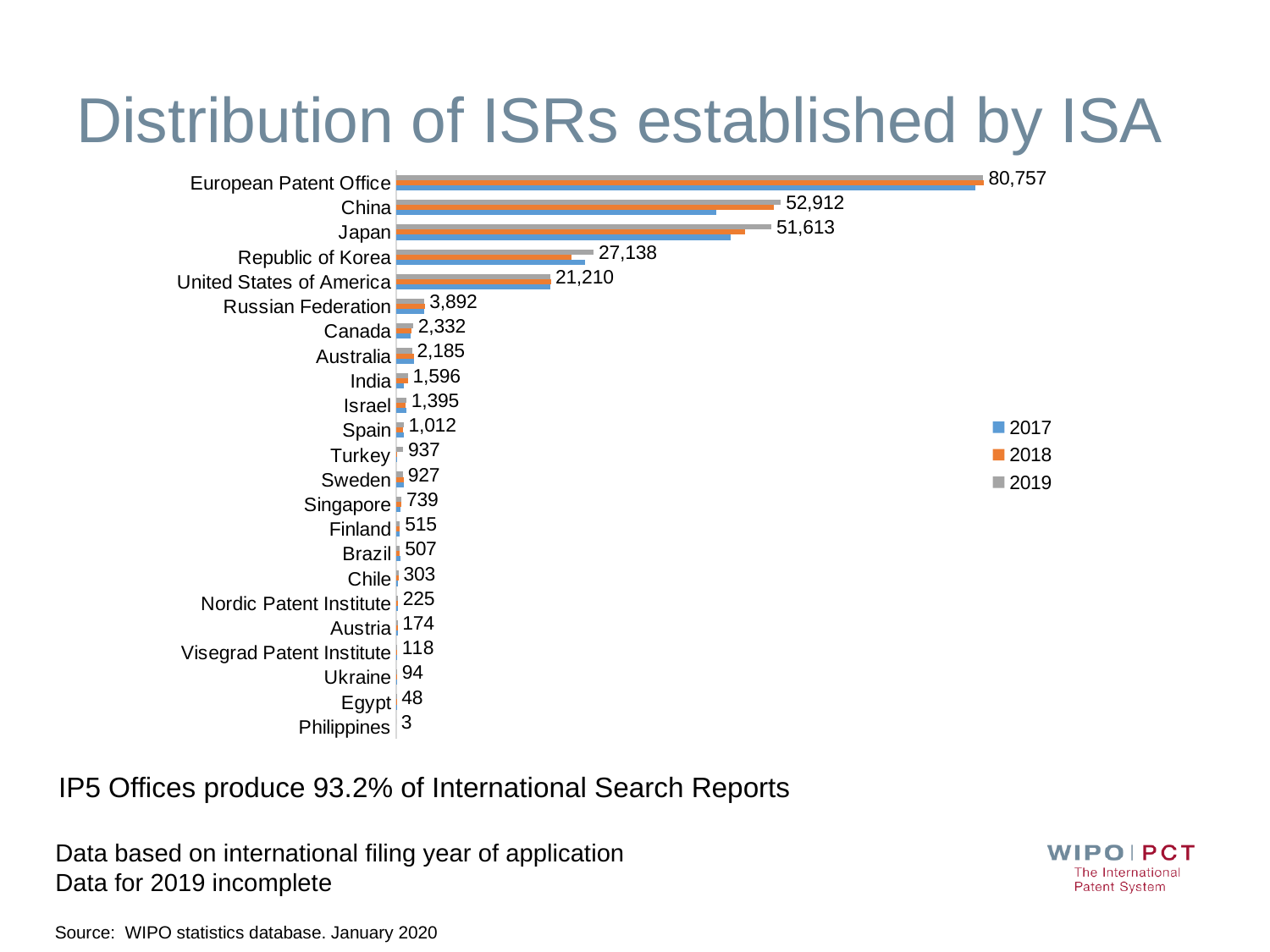
Which ISA has the highest number of ISRs established? European Patent Office Which years are listed in the legend? 2017, 2018, 2019 How many series does the legend list? 3 What value is labelled for the European Patent Office? 80,757 What is the difference between the labelled values for China and Japan? 1,299 Which has the larger labelled value, Canada or Australia? Canada What value is labelled for Japan? 51,613 Which ISA has the lowest number of ISRs established? Philippines What kind of chart is shown on the slide? bar chart What value is labelled for the Philippines? 3 How many ISAs (categories) are shown on the chart? 23 What value is labelled for the Russian Federation? 3,892